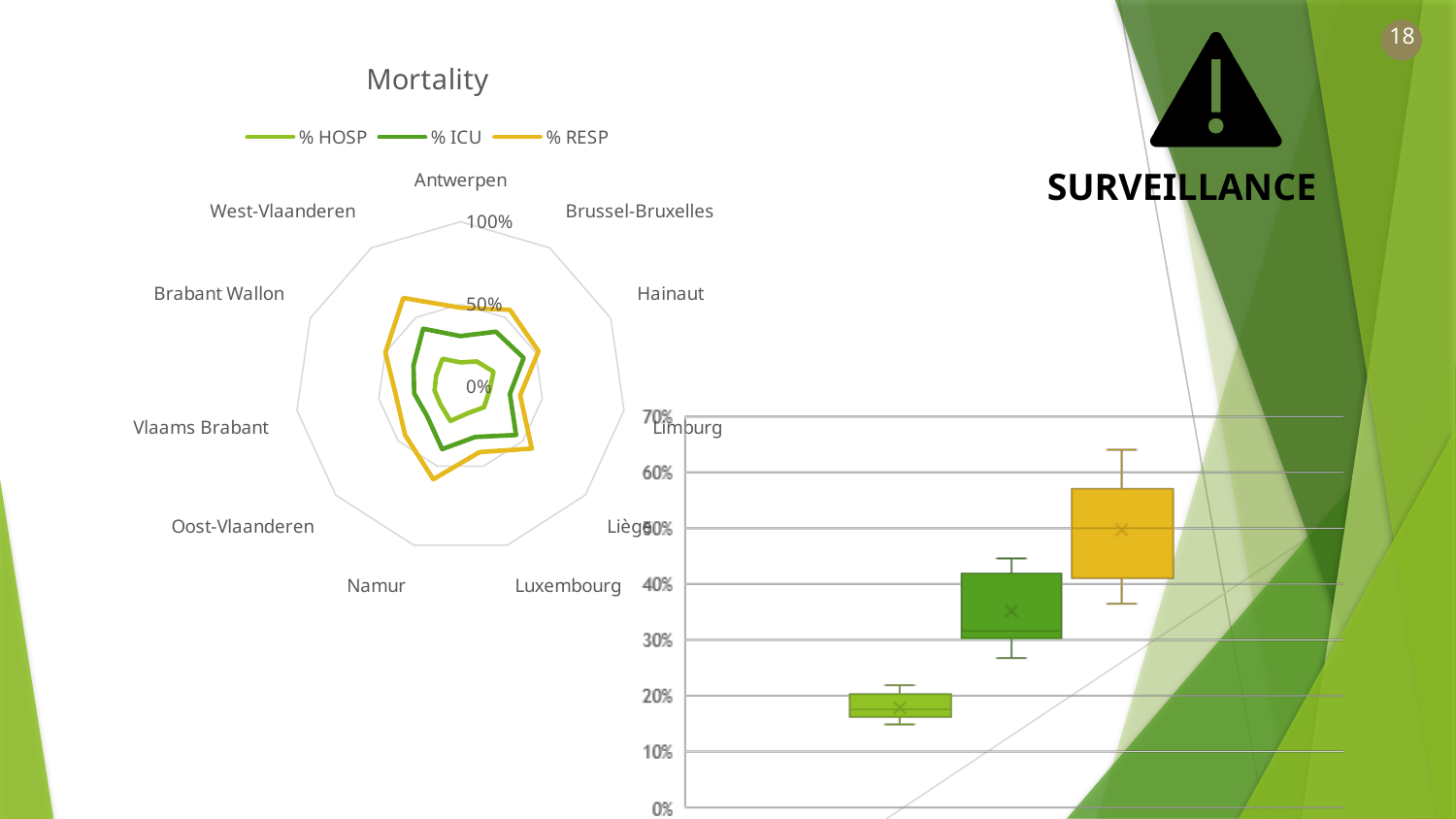
How many series does the legend of the "Mortality" chart list? 3 In the box plot at the bottom right, is the top of the leftmost (light green) box greater or less than 30%? less In the "Mortality" chart, is the % RESP value for Limburg greater or less than 100%? less In the "Mortality" chart, which series has the highest value for Antwerpen? % RESP In the "Mortality" chart, which series has the lowest value for Hainaut? % HOSP In the "Mortality" chart, is the % HOSP value for Antwerpen greater or less than 50%? less What are the series names in the legend of the "Mortality" chart? % HOSP, % ICU, % RESP What is the title of the radar chart on the left of the slide? Mortality What kind of chart is the chart at the bottom right of the slide? box plot How many categories (provinces) are shown around the "Mortality" radar chart? 11 In the box plot at the bottom right, how many boxes are plotted? 3 What kind of chart is the chart titled "Mortality"? radar chart